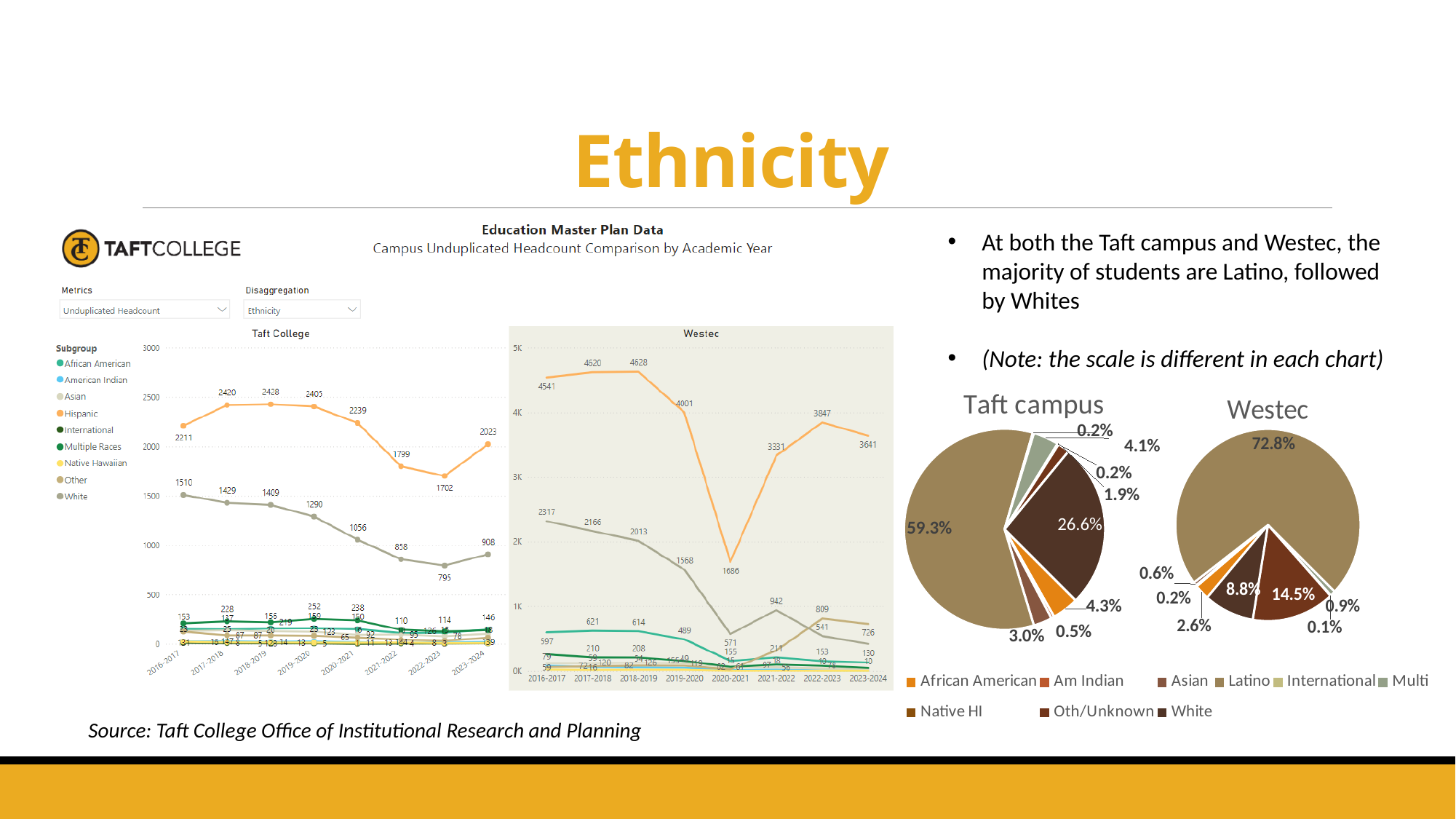
In the Westec pie chart, what share of students is White? 8.8% In the Westec pie chart, what share of students is Latino? 72.8% How many academic years are shown on the x axis of the Taft College line chart? 8 In the Westec line chart, what is the difference between the Hispanic headcount in 2018-2019 and in 2020-2021? 2942 In the Westec line chart, what is the Hispanic headcount for 2020-2021? 1686 How many ethnicity categories does the legend below the two pie charts list? 9 In the Taft College line chart, does the White headcount rise or fall from 2016-2017 to 2022-2023? Fall What kind of chart is the Taft campus chart on the right side of the slide? Pie chart In the Taft College line chart, what is the Hispanic headcount for 2018-2019? 2428 In the Taft College line chart, what is the White headcount for 2022-2023? 795 In the Westec line chart, what is the White headcount for 2016-2017? 2317 In the Taft campus pie chart, what share of students is Latino? 59.3%